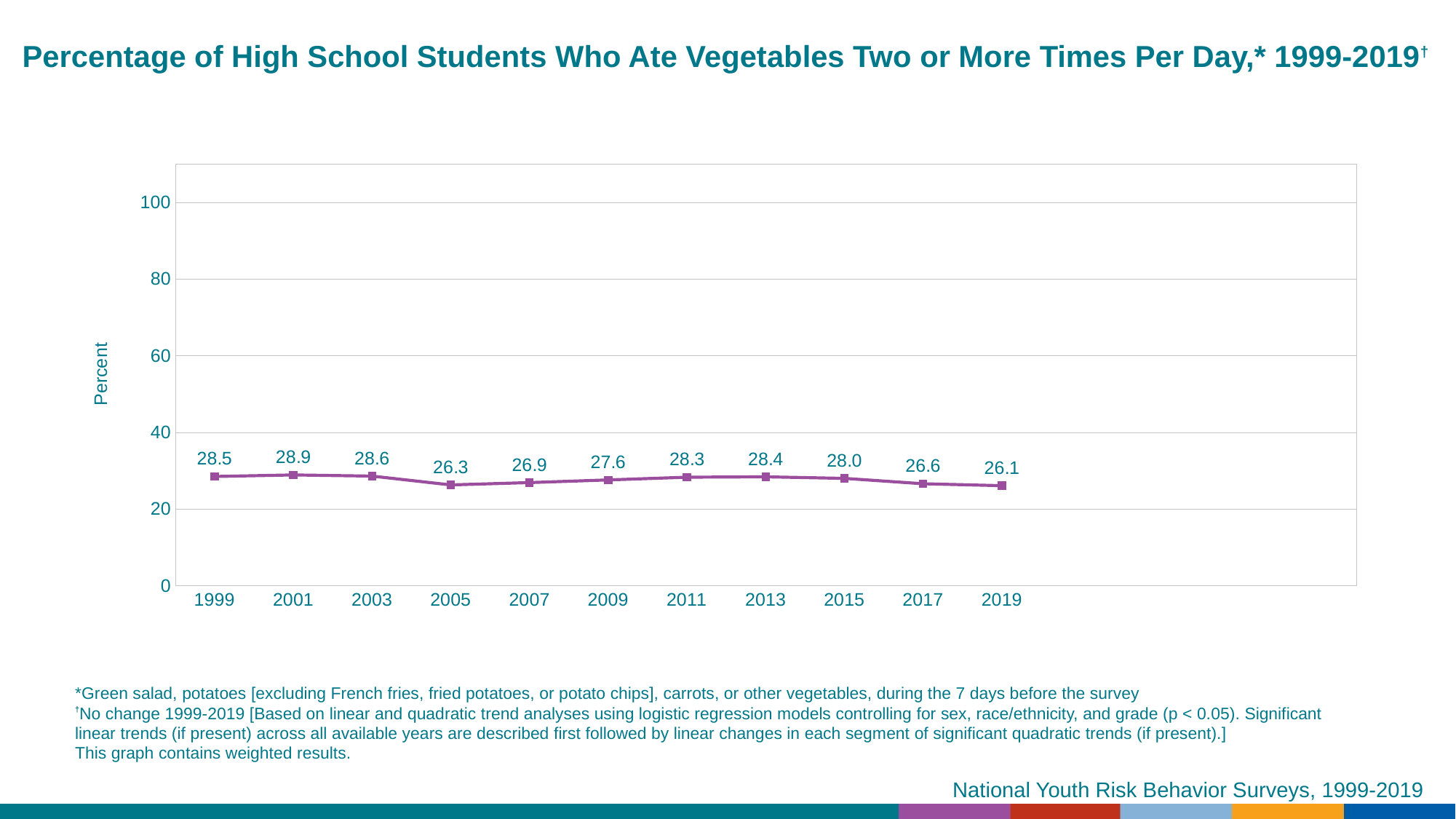
Which year has the lowest value on the chart? 2019 What is the value shown for 2019? 26.1 Is the value for 2015 greater or less than 40? less Which year has the highest value on the chart? 2001 What kind of chart is shown on the slide? line chart How many years are plotted on the chart? 11 What is the label on the y axis? Percent What is the difference between the values for 2003 and 2005? 2.3 What is the difference between the values for 2001 and 2019? 2.8 What percentage of high school students ate vegetables two or more times per day in 1999? 28.5 Which is larger, the value for 2007 or the value for 2011? 2011 What is the value shown for 2009? 27.6